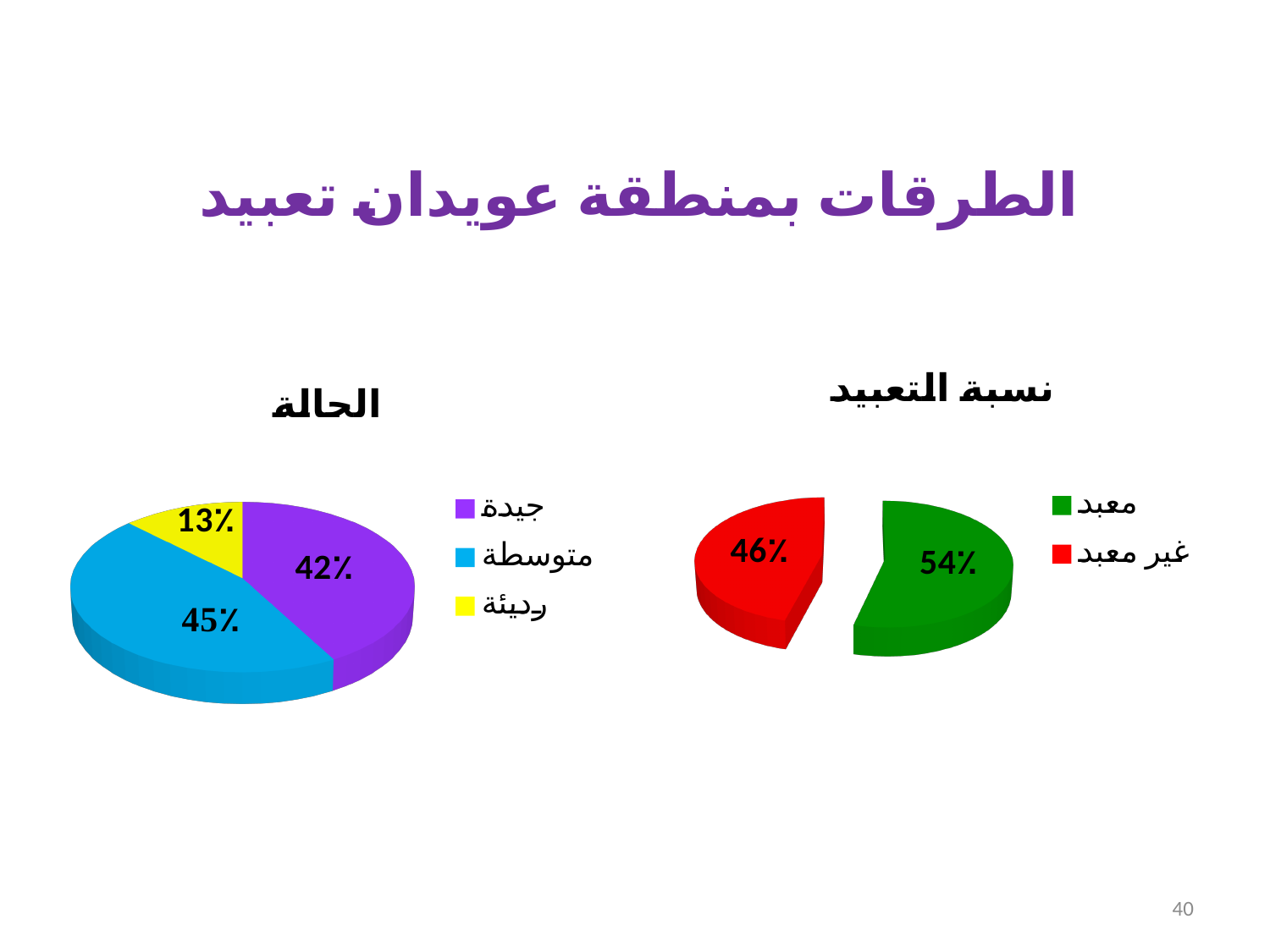
In the chart titled الحالة, what percentage is shown for متوسطة? 45% In the chart titled نسبة التعبيد, what percentage is shown for معبد? 54% In the chart titled الحالة, what percentage is shown for رديئة? 13% In the chart titled الحالة, which category has the smallest share? رديئة In the chart titled الحالة, what is the difference in percentage points between متوسطة and رديئة? 32 What type of chart is the chart titled نسبة التعبيد? Pie chart In the chart titled نسبة التعبيد, which category has the larger share, معبد or غير معبد? معبد In the chart titled الحالة, what percentage is shown for جيدة? 42% In the chart titled الحالة, which category has the largest share? متوسطة In the chart titled نسبة التعبيد, what is the difference in percentage points between معبد and غير معبد? 8 In the chart titled نسبة التعبيد, what percentage is shown for غير معبد? 46% How many slices does the chart titled الحالة have? 3